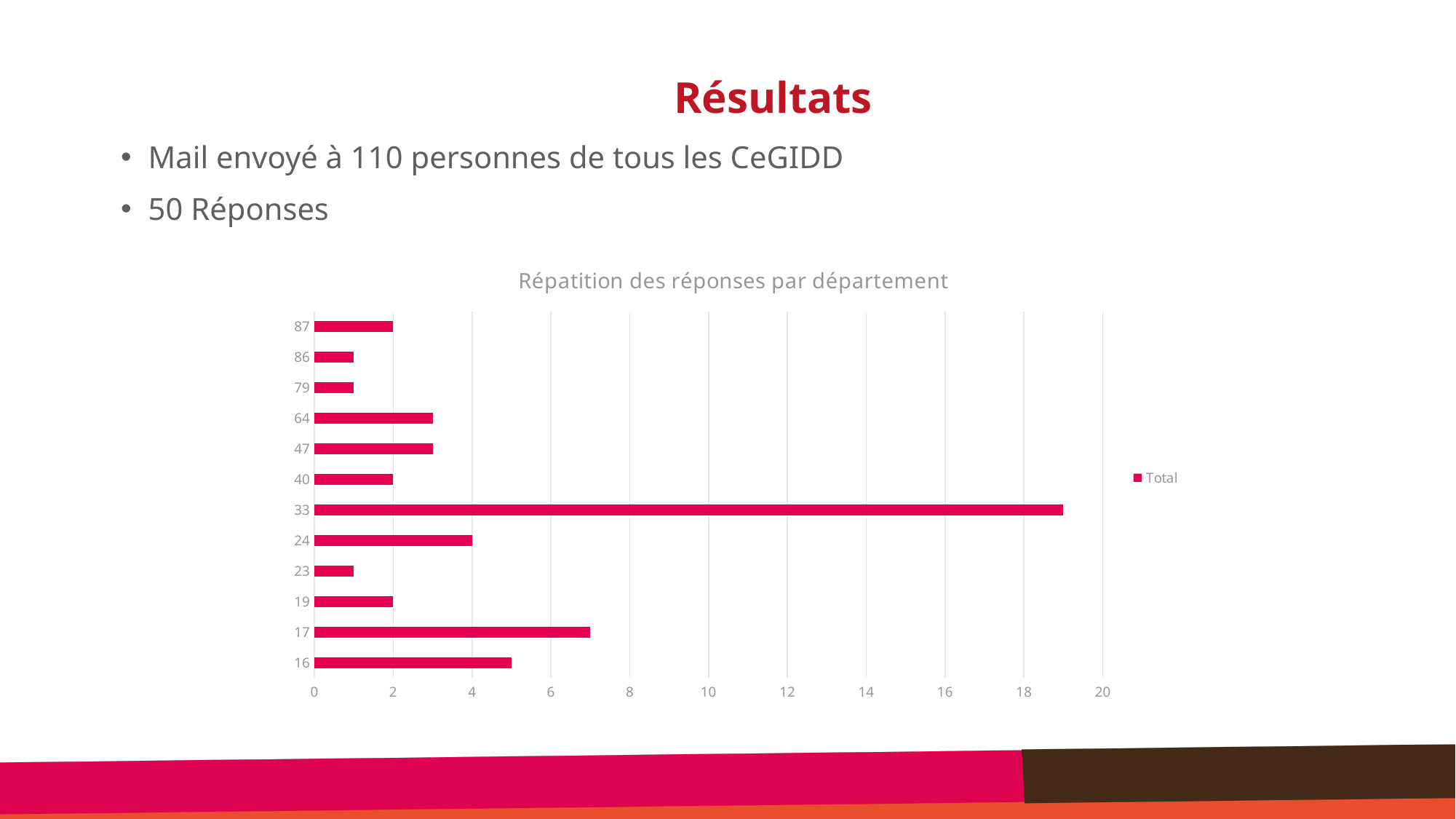
What is the value for department 24? 4 What is the value for department 87? 2 Is the value for department 33 greater or less than 18? greater Is the value for department 86 greater or less than 2? less What is the difference between the values for department 24 and department 87? 2 What is the title of the chart? Répatition des réponses par département Which department has the highest number of responses? 33 Which has a larger value, department 17 or department 16? 17 How many departments (categories) are plotted in the chart? 12 What kind of chart is shown on the slide? bar chart How many series does the legend list? 1 Is the value for department 17 greater or less than 6? greater